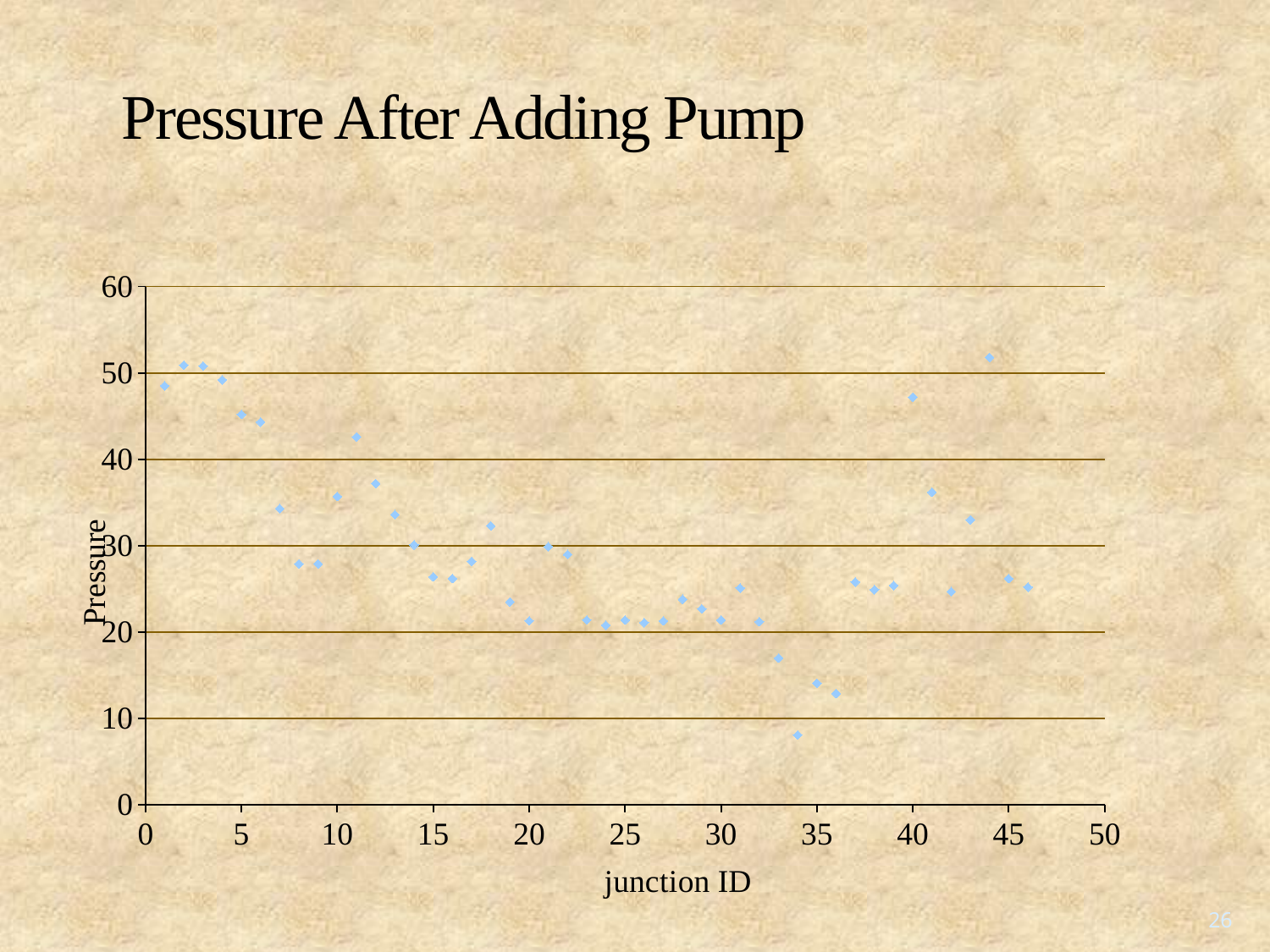
Which has the higher pressure, junction ID 5 or junction ID 35? Junction ID 5 Which junction ID has the lowest pressure? 34 Which has the higher pressure, junction ID 11 or junction ID 12? Junction ID 11 What is the title of the chart? Pressure After Adding Pump Is the pressure for junction ID 7 greater or less than 30? greater What is the label on the x axis of the chart? junction ID Is the pressure for junction ID 33 greater or less than 20? less Is the pressure for junction ID 34 greater or less than 10? less What kind of chart is shown on the slide? Scatter chart